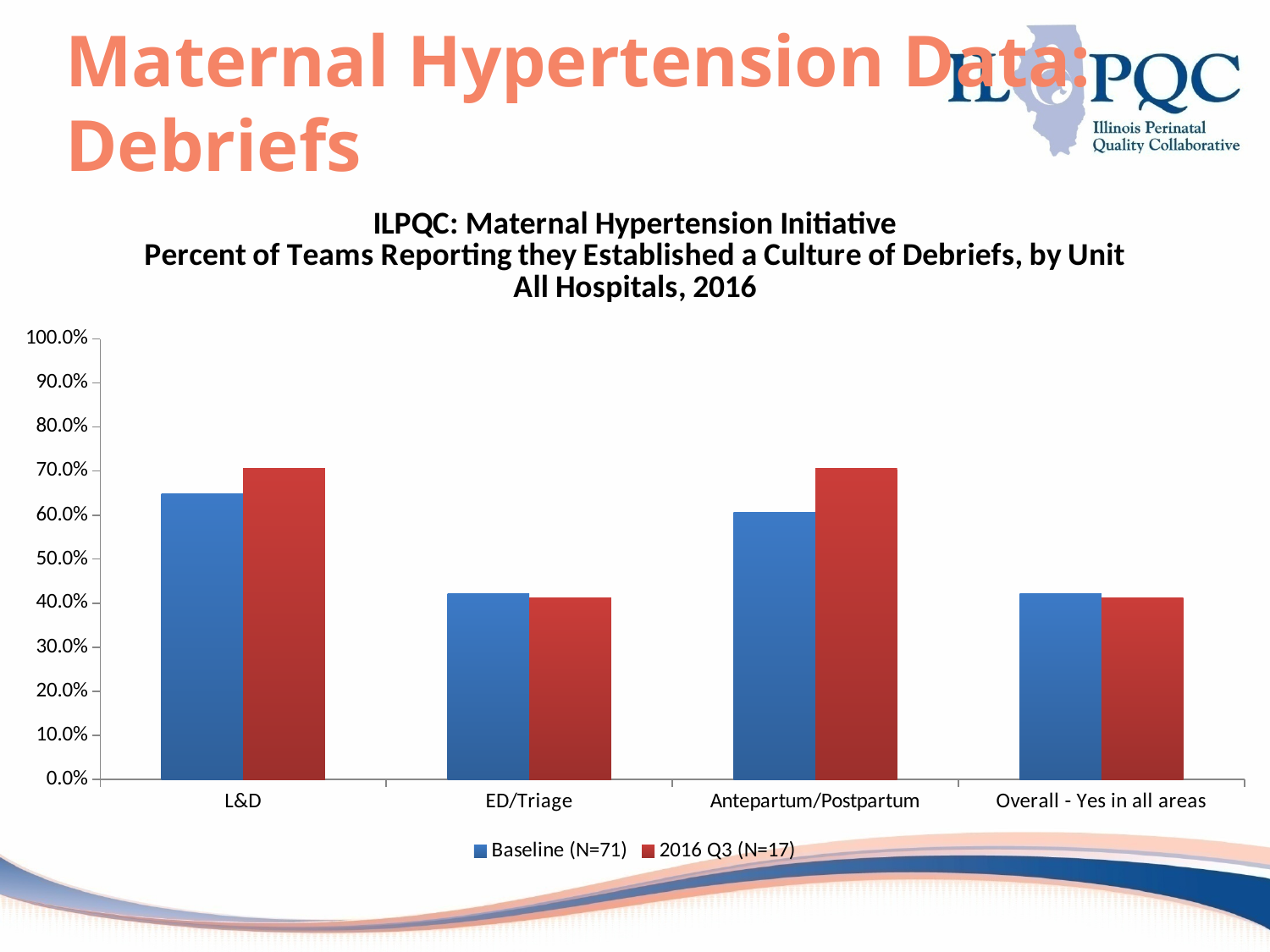
Which series is shown in red? 2016 Q3 (N=17) Which unit has the highest Baseline (N=71) value? L&D For Antepartum/Postpartum, which is larger: the Baseline (N=71) value or the 2016 Q3 (N=17) value? 2016 Q3 (N=17) For L&D, which is larger: the Baseline (N=71) value or the 2016 Q3 (N=17) value? 2016 Q3 (N=17) Is the 2016 Q3 (N=17) value for Overall - Yes in all areas greater or less than 50.0%? less What are the two series named in the legend? Baseline (N=71) and 2016 Q3 (N=17) Is the Baseline (N=71) value for ED/Triage greater or less than 50.0%? less How many series does the legend list? 2 Is the Baseline (N=71) value for L&D greater or less than 60.0%? greater How many unit categories are shown on the x axis? 4 What kind of chart is shown on the slide? bar chart